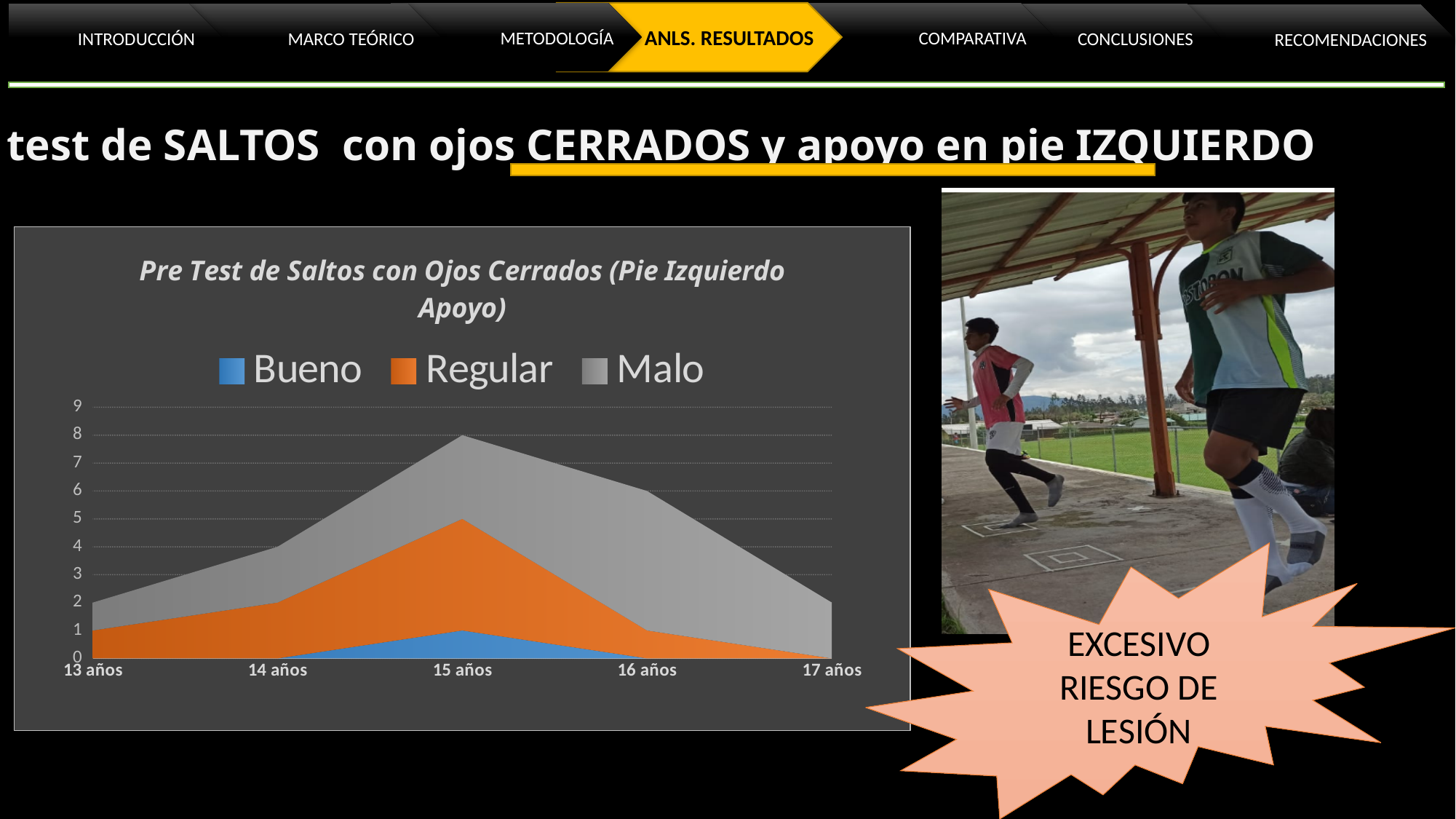
Is the total stacked value at 13 años greater or less than 3? less What is the title of the chart? Pre Test de Saltos con Ojos Cerrados (Pie Izquierdo Apoyo) Is the total stacked value at 16 años greater or less than 4? greater Which has a larger total stacked value, 15 años or 13 años? 15 años What kind of chart is shown on the slide? area chart Do the total stacked values rise or fall from 13 años to 15 años? rise How many series does the legend list? 3 Is the total stacked value at 15 años greater or less than 6? greater What are the series names in the legend? Bueno, Regular, Malo Which age category has the highest total stacked value? 15 años How many age categories are shown on the x axis? 5 Do the total stacked values rise or fall from 15 años to 17 años? fall